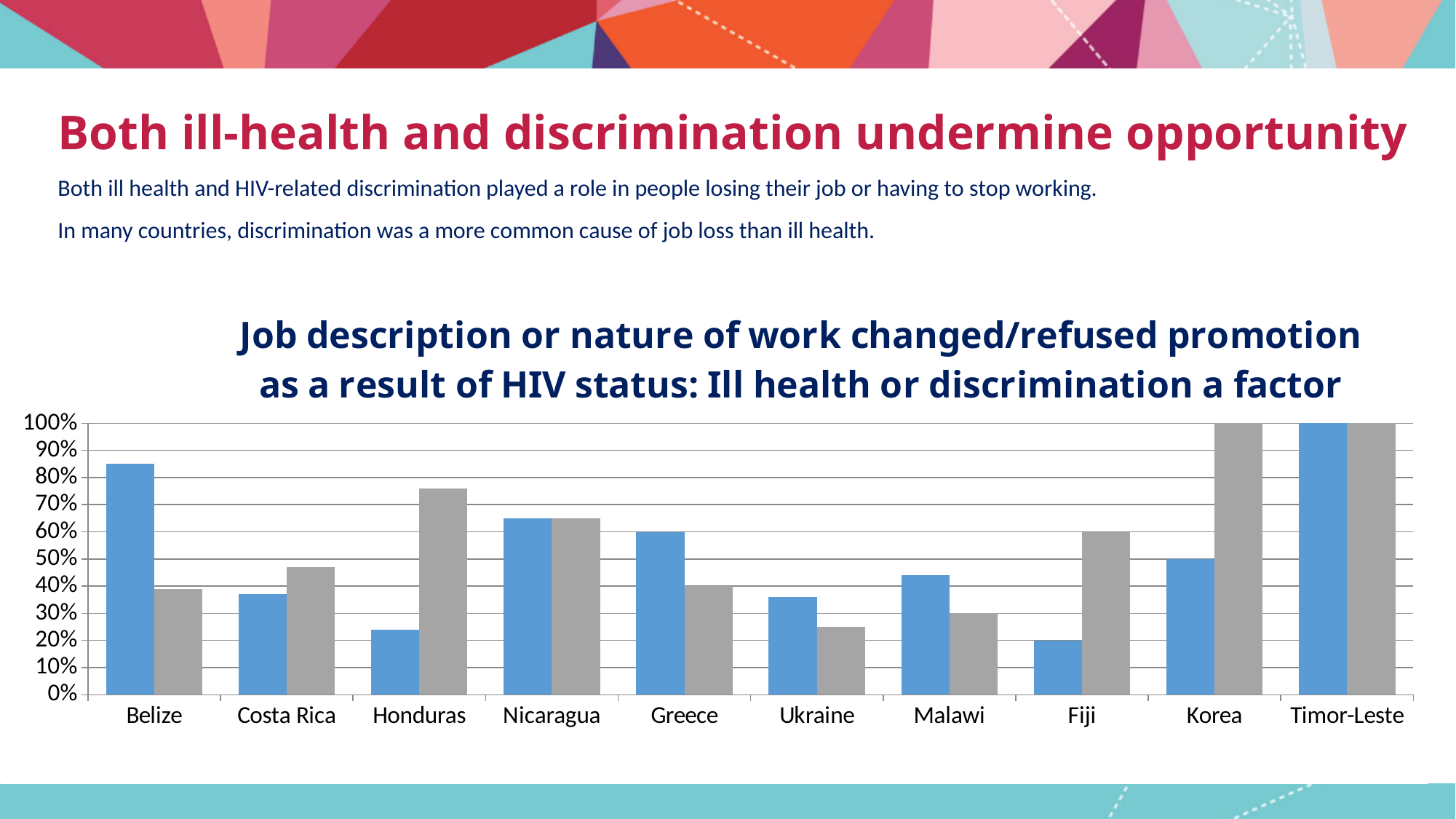
For Honduras, which is larger, the blue bar or the grey bar? the grey bar Is the grey bar for Honduras greater or less than 70%? greater Which country has the highest blue bar? Timor-Leste What is the value of the blue bar for Korea? 50% What is the value of the blue bar for Fiji? 20% How many countries are shown on the x axis of the chart? 10 What is the difference between the grey bar and the blue bar for Korea? 50% Is the blue bar for Belize greater or less than 80%? greater Which country has the lowest grey bar? Ukraine What is the value of the grey bar for Korea? 100% What is the value of the blue bar for Timor-Leste? 100% What kind of chart is shown on the slide? bar chart